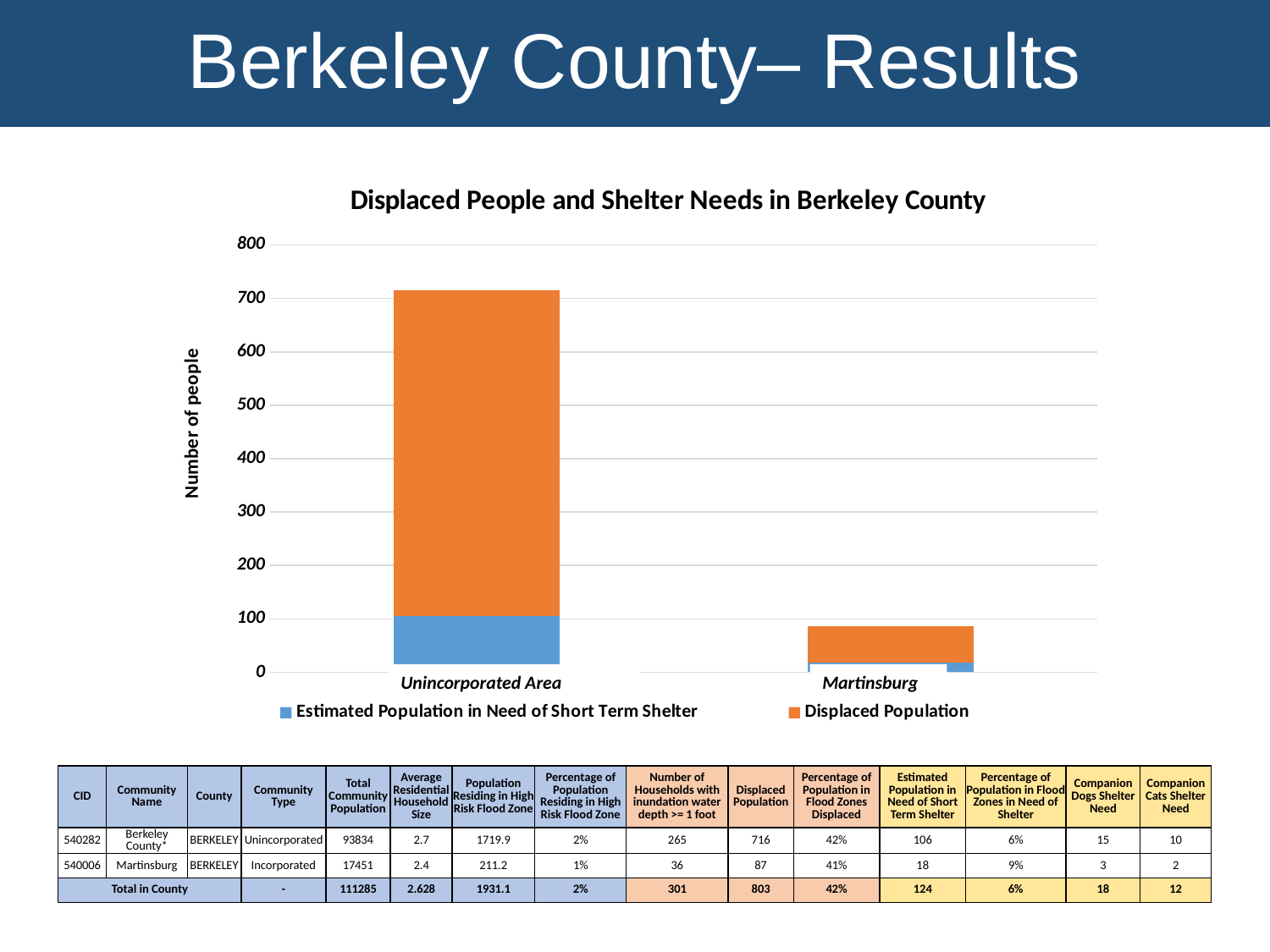
How many categories are shown on the x axis of the chart? 2 What is the title of the chart? Displaced People and Shelter Needs in Berkeley County How many series does the chart legend list? 2 Which category has the lowest Displaced Population in the chart? Martinsburg What is the label on the y axis of the chart? Number of people Is the Estimated Population in Need of Short Term Shelter for Unincorporated Area greater or less than 200? less What type of chart is shown on the slide? bar chart Which has a larger Displaced Population, Unincorporated Area or Martinsburg? Unincorporated Area Is the Displaced Population for Martinsburg greater or less than 100? less Which category has the larger Estimated Population in Need of Short Term Shelter, Unincorporated Area or Martinsburg? Unincorporated Area Which category has the highest Displaced Population in the chart? Unincorporated Area